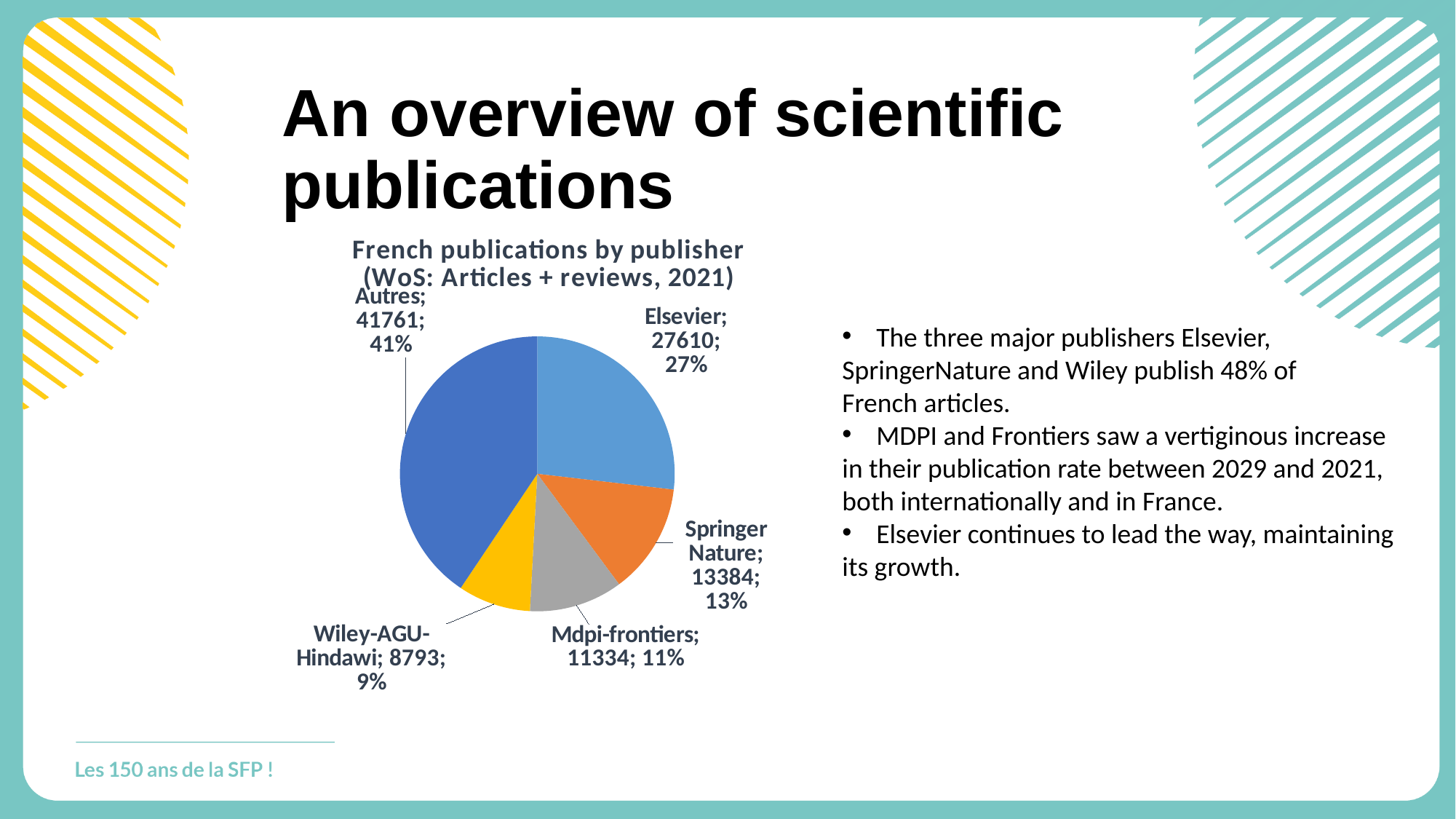
How many publications does the chart show for Elsevier? 27610 Which slice of the pie is the smallest? Wiley-AGU-Hindawi How many publications are shown for Mdpi-frontiers? 11334 Which has more publications, Mdpi-frontiers or Wiley-AGU-Hindawi? Mdpi-frontiers What share of the pie does Springer Nature hold? 13% What is the difference in publications between Elsevier and Springer Nature? 14226 What kind of chart is shown on the slide? pie chart What is the title of the chart? French publications by publisher (WoS: Articles + reviews, 2021) Which slice of the pie is the largest? Autres What percentage of the pie is Wiley-AGU-Hindawi? 9% How many slices does the pie chart have? 5 What share of the pie does Autres hold? 41%